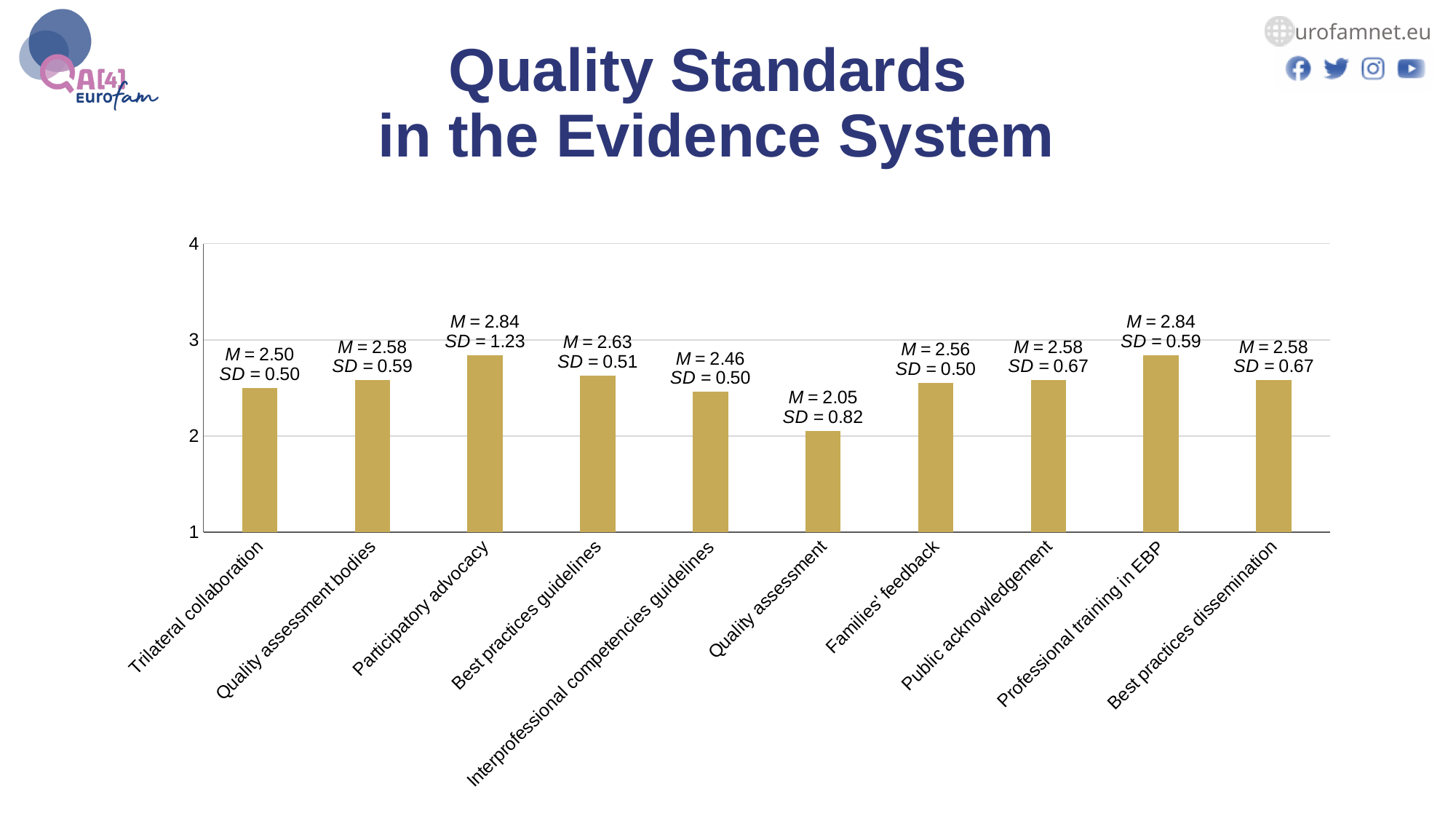
What is the difference between the mean values for Participatory advocacy and Quality assessment? 0.79 What is the SD value for Public acknowledgement? 0.67 How many categories are shown on the x axis? 10 What is the difference between the mean values for Best practices guidelines and Trilateral collaboration? 0.13 What is the mean (M) value for Best practices guidelines? 2.63 What is the title of the slide containing the chart? Quality Standards in the Evidence System Which has a larger mean value, Families' feedback or Interprofessional competencies guidelines? Families' feedback Is the mean value for Professional training in EBP greater or less than 3? less Which category has the lowest mean value? Quality assessment What kind of chart is shown on the slide? bar chart What is the SD value for Participatory advocacy? 1.23 What is the mean (M) value for Quality assessment? 2.05